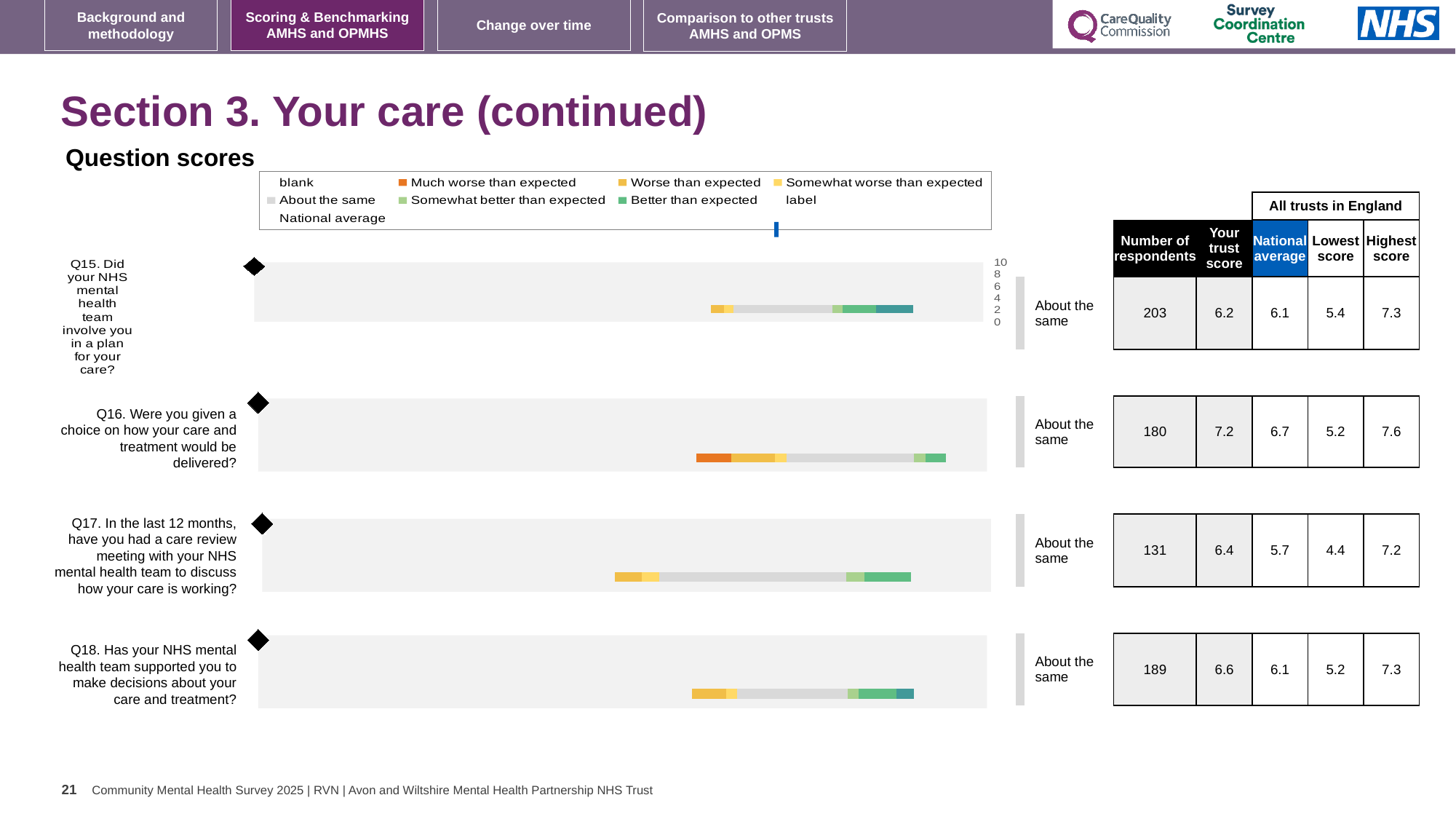
How many questions (Q15 to Q18) have a score bar plotted on the slide? 4 Which question (Q15 to Q18) has the highest trust score in the table? Q16 In the table beside the Q17 bar, what is the national average? 5.7 What kind of chart is used to show the question scores for Q15 to Q18? bar chart Which legend entry is shown with the dark orange colour? Much worse than expected Which question (Q15 to Q18) has the lowest number of respondents in the table? Q17 What rating label is shown next to the bar for Q16? About the same In the table beside the Q15 bar, what is the number of respondents? 203 What is the difference between the trust score and the national average for Q16 in the table? 0.5 In the table beside the Q18 bar, what is the highest score among all trusts in England? 7.3 In the table beside the Q16 bar, what is the trust score? 7.2 For Q17, which is larger in the table: the trust score or the national average? trust score